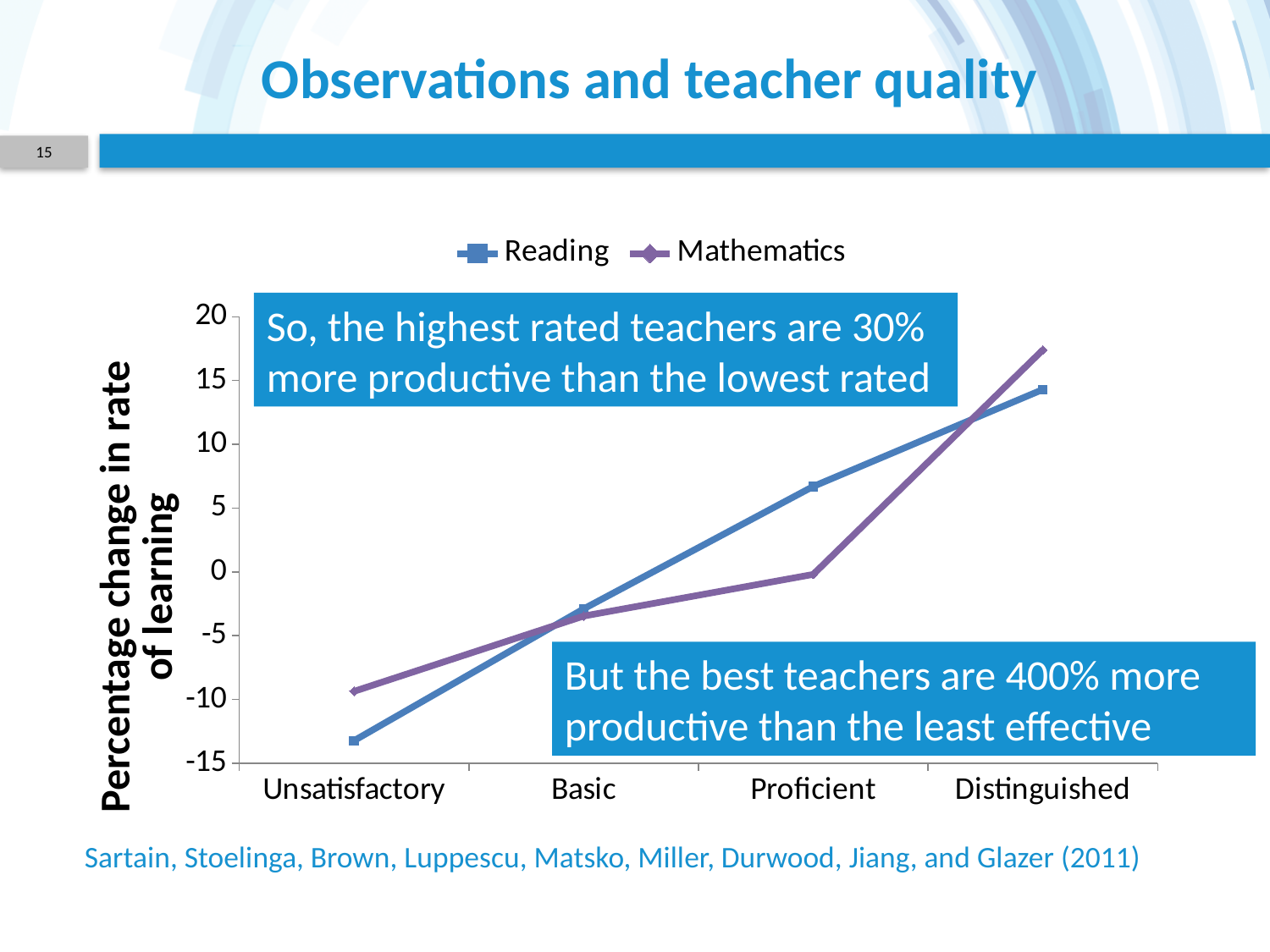
Do the Reading values rise or fall from Unsatisfactory to Distinguished? rise Is the Mathematics value for Distinguished greater or less than 15? greater Is the Reading value for Unsatisfactory greater or less than -10? less Which category has the lowest Mathematics value? Unsatisfactory At Proficient, which series has the larger value, Reading or Mathematics? Reading Is the Reading value for Proficient greater or less than 5? greater What kind of chart is shown on the slide? line chart How many series does the legend list? 2 What is the title of the vertical axis? Percentage change in rate of learning At Distinguished, which series has the larger value, Reading or Mathematics? Mathematics How many categories are shown on the x axis? 4 Which category has the highest Reading value? Distinguished